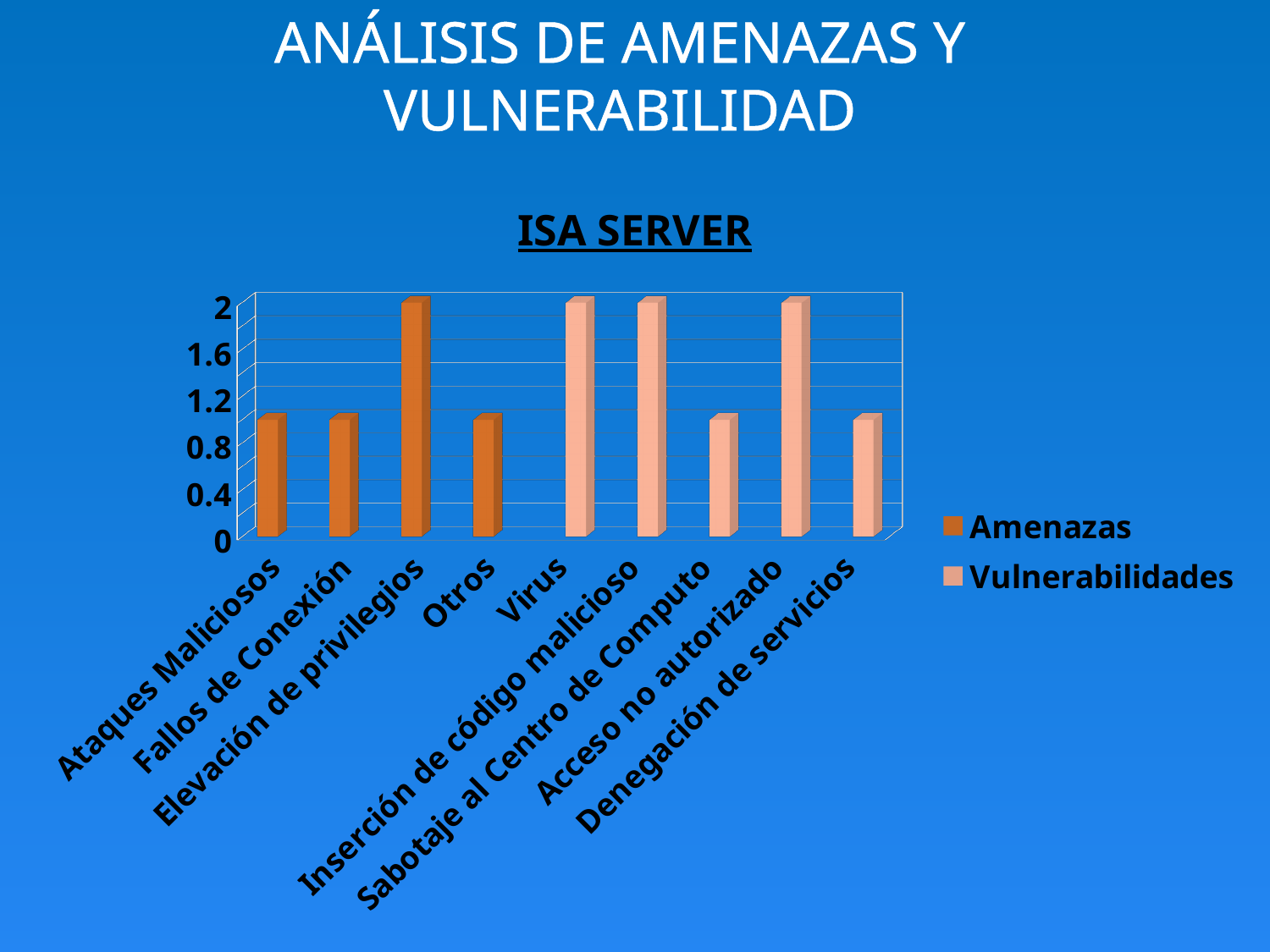
What type of chart is shown on the slide? Bar chart Which is larger, the value for Elevación de privilegios or the value for Otros? Elevación de privilegios Is the value for Otros greater or less than 1.2? less What is the value for Virus? 2 Which legend entry is shown in the lighter pink colour? Vulnerabilidades Which is larger, the value for Sabotaje al Centro de Computo or the value for Acceso no autorizado? Acceso no autorizado What is the value for Elevación de privilegios? 2 Is the value for Fallos de Conexión greater or less than 0.8? greater How many series does the legend list? 2 What is the title of the chart? ISA SERVER What is the value for Acceso no autorizado? 2 How many categories are shown on the x axis of the chart? 9